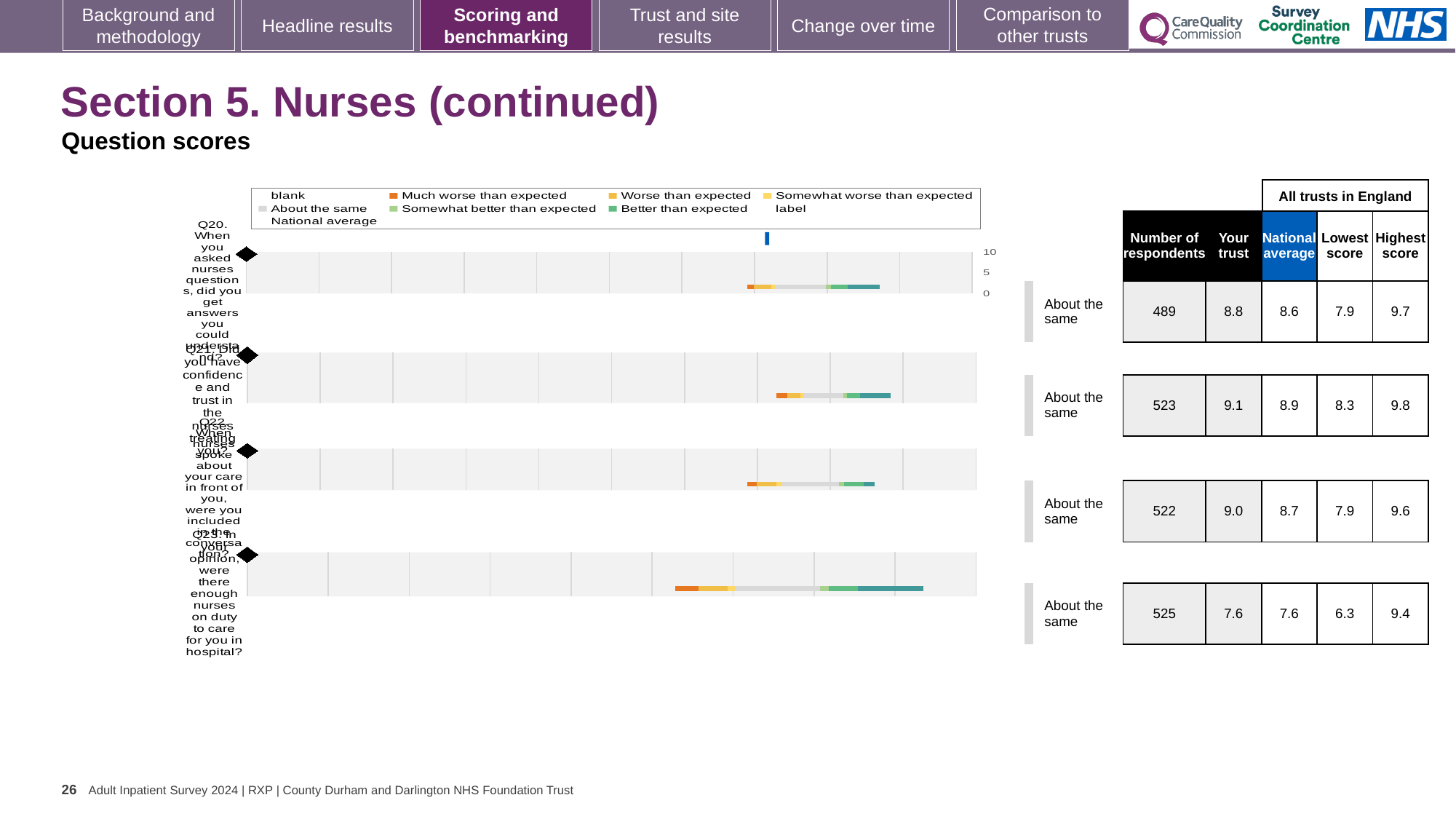
What is the 'Your trust' score for Q21 (did you have confidence and trust in the nurses treating you)? 9.1 What is the number of respondents for Q20 (when you asked nurses questions, did you get answers you could understand)? 489 What kind of chart is used to show the question scores on this slide? bar chart For Q22, how much higher is the 'Your trust' score than the national average? 0.3 How many questions (Q20 to Q23) are plotted in the chart? 4 For Q20, which is larger: the 'Your trust' score or the national average? Your trust What benchmark category is shown for Q23? About the same What is the national average score for Q23 (were there enough nurses on duty to care for you in hospital)? 7.6 Which question has the lowest 'Your trust' score? Q23 What colour in the legend represents 'Much worse than expected'? orange What is the highest score among all trusts in England for Q21? 9.8 Which question has the highest 'Your trust' score? Q21